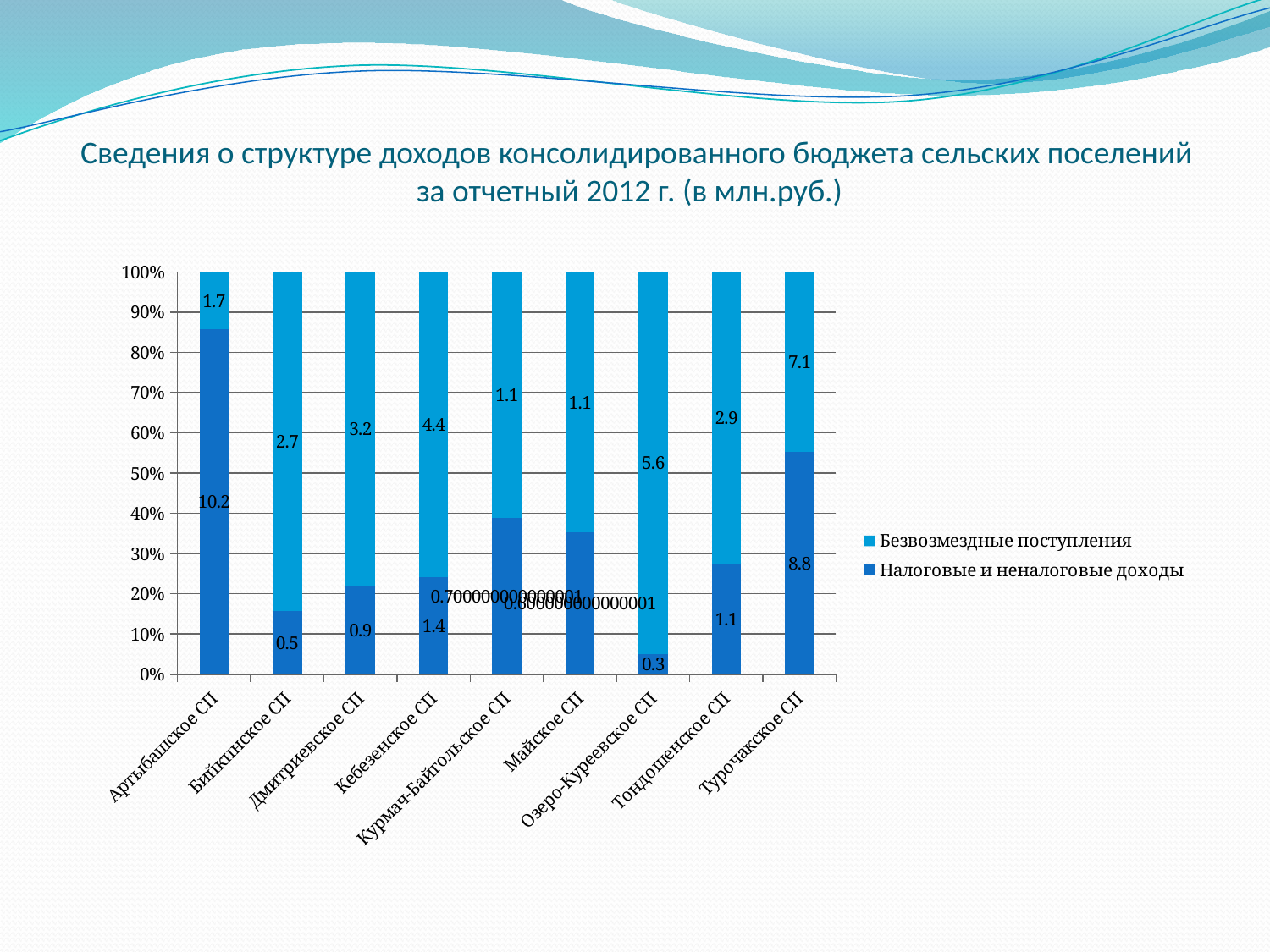
Which category has the lowest value of Налоговые и неналоговые доходы? Озеро-Куреевское СП How many series does the legend list? 2 Which category has the highest value of Безвозмездные поступления? Турочакское СП Which category has the highest value of Налоговые и неналоговые доходы? Артыбашское СП What is the value of Безвозмездные поступления for Турочакское СП? 7.1 What is the value of Налоговые и неналоговые доходы for Артыбашское СП? 10.2 What kind of chart is shown on the slide? Stacked bar chart What is the value of Безвозмездные поступления for Озеро-Куреевское СП? 5.6 What is the difference between Безвозмездные поступления for Кебезенское СП and Дмитриевское СП? 1.2 What is the value of Налоговые и неналоговые доходы for Тондошенское СП? 1.1 How many categories are shown on the x axis? 9 Which is larger: Налоговые и неналоговые доходы for Турочакское СП or for Бийкинское СП? Турочакское СП